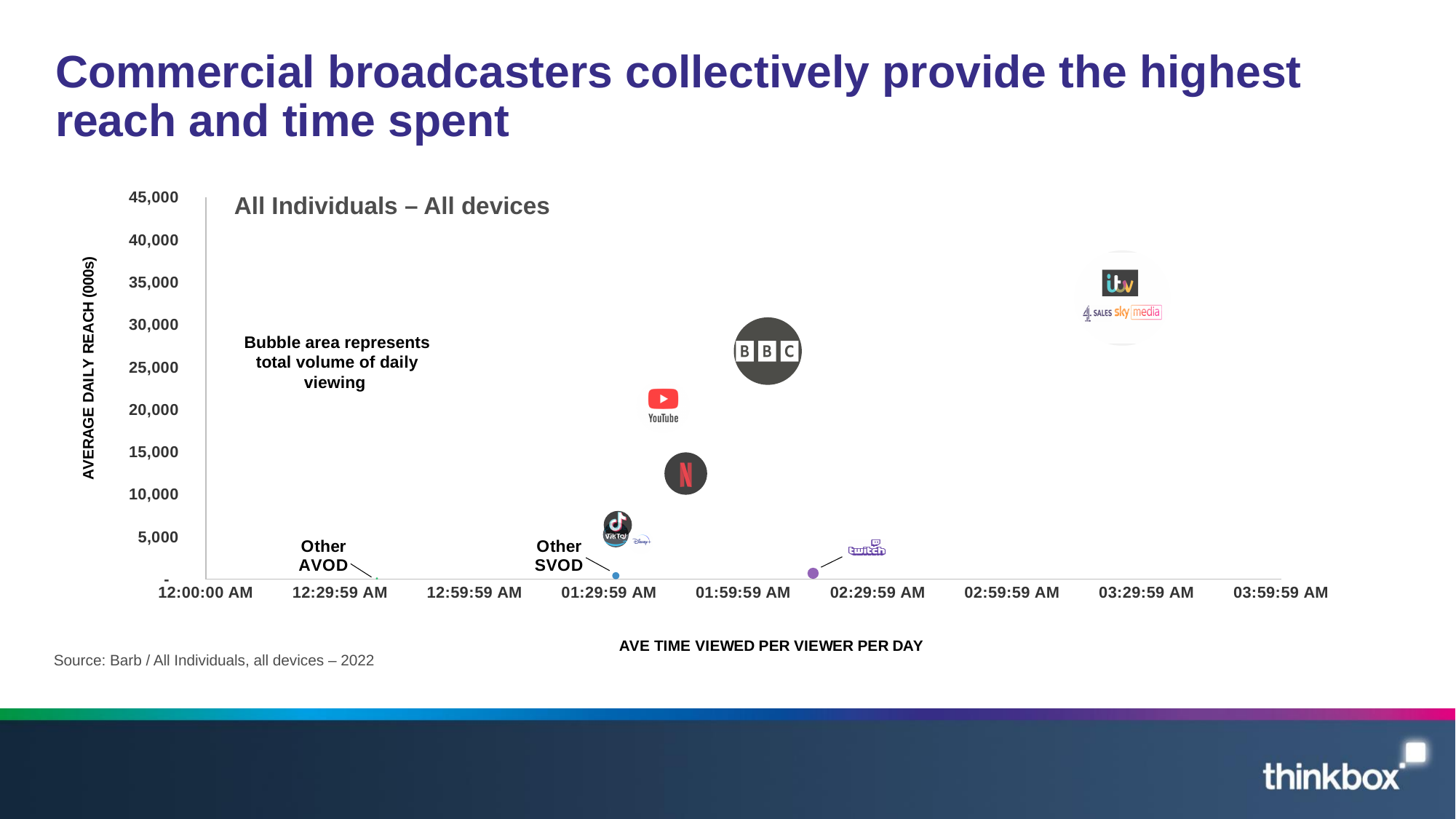
Which has the longer average time viewed per viewer per day, BBC or YouTube? BBC What does the bubble area represent in this chart? Total volume of daily viewing Is the average daily reach for Twitch greater or less than 5,000? less Is the average daily reach for the commercial broadcasters bubble greater or less than 30,000? greater Which bubble has the shortest average time viewed per viewer per day? Other AVOD What is the title of the y-axis? AVERAGE DAILY REACH (000s) Which has the higher average daily reach, BBC or Netflix? BBC Which bubble has the highest average daily reach? Commercial broadcasters (ITV, 4 Sales, Sky Media) Which bubble has the longest average time viewed per viewer per day? Commercial broadcasters (ITV, 4 Sales, Sky Media) What kind of chart is shown on the slide? Bubble chart Is the average daily reach for Netflix greater or less than 15,000? less